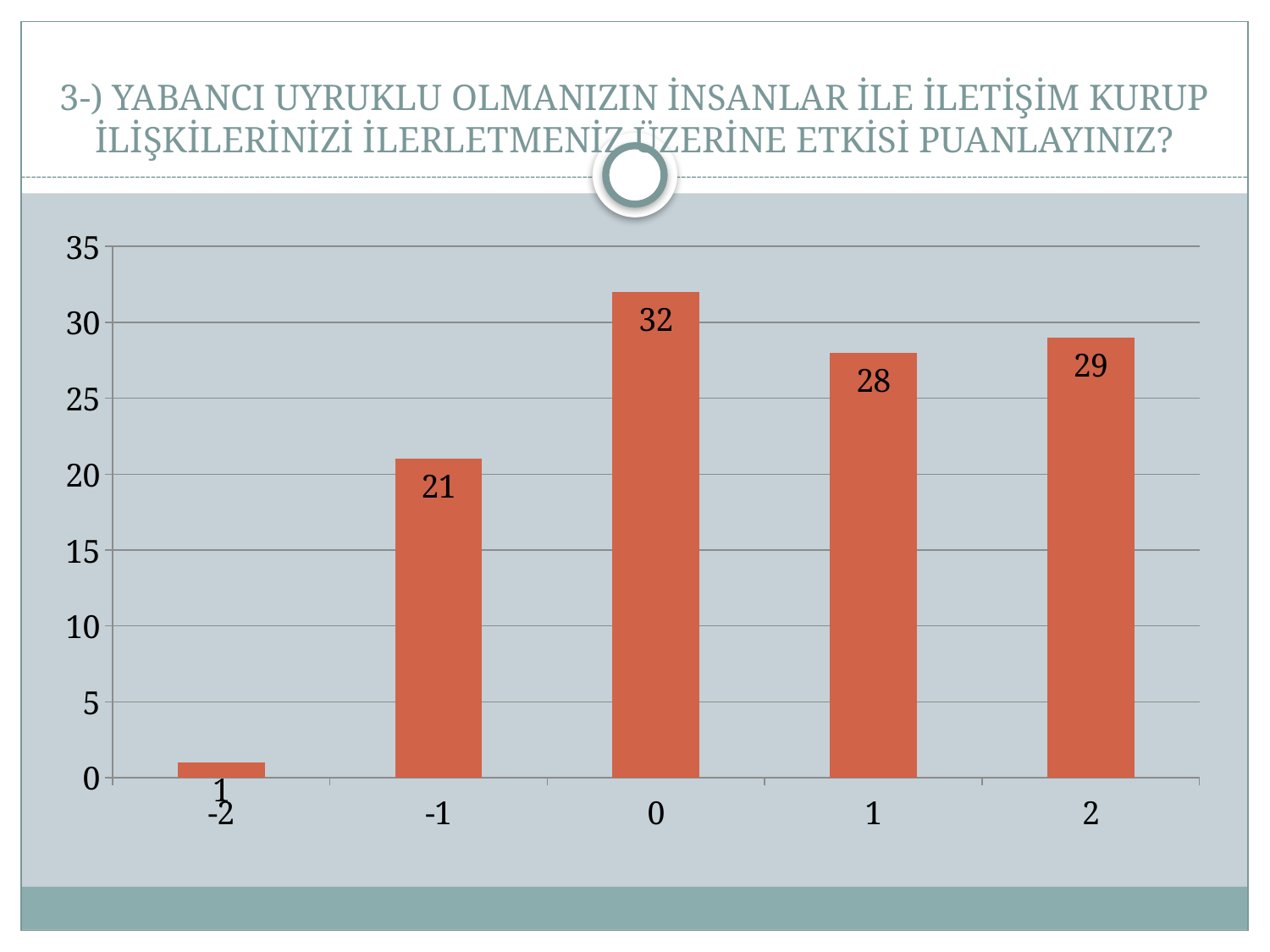
What is the difference between the values for category 2 and category -1? 8 Which category has the lowest value? -2 What is the value for category -1? 21 What is the value for category -2? 1 What is the value for category 2? 29 Which has a larger value, category 1 or category 2? 2 Which category has the highest value? 0 What kind of chart is shown on the slide? bar chart What is the value for category 0? 32 What is the difference between the values for category 0 and category 1? 4 How many categories are shown on the x axis? 5 Is the value for category -1 greater or less than 25? less